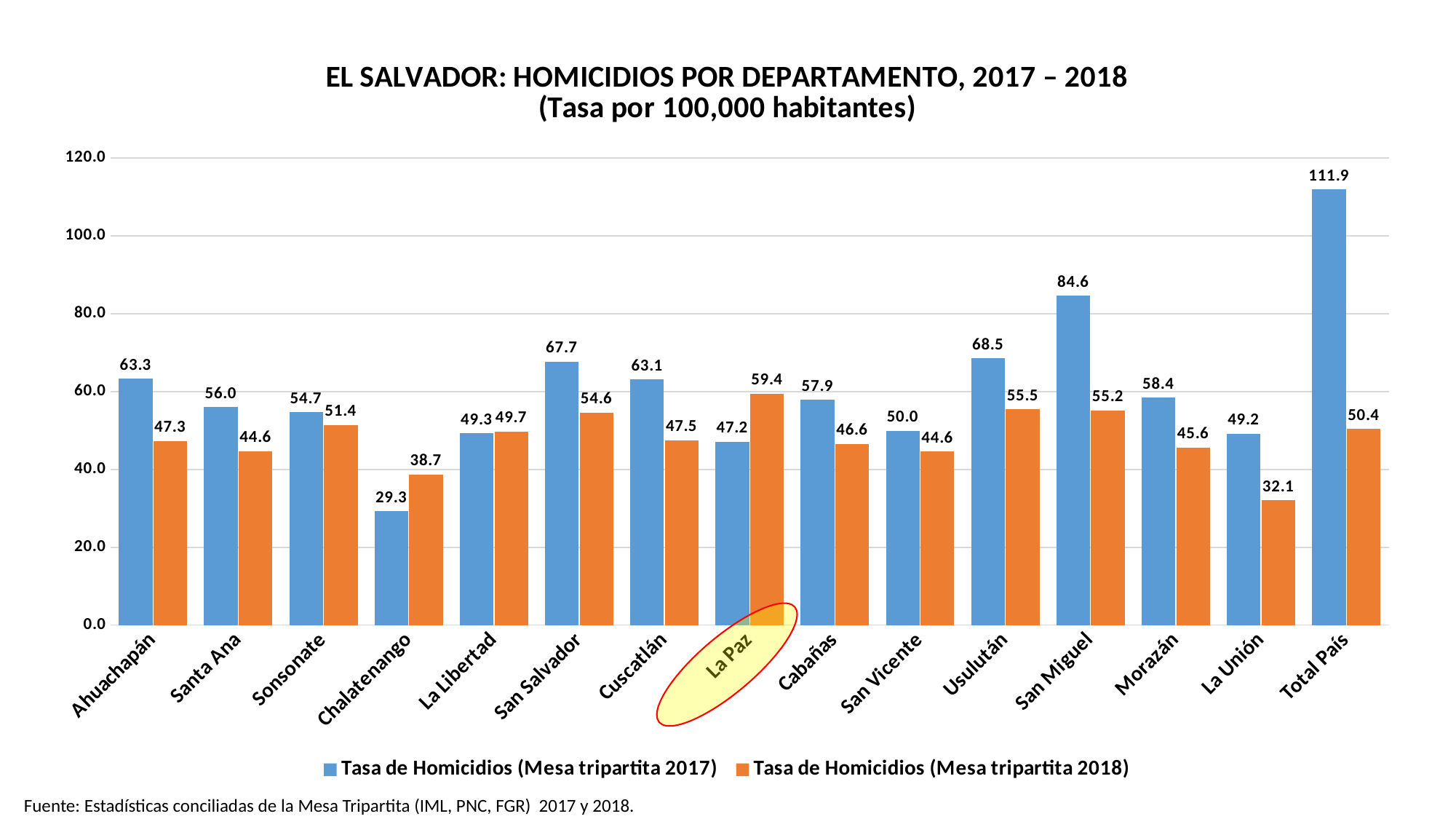
What is the 2018 homicide rate for Total País? 50.4 What is the 2018 homicide rate (Mesa tripartita 2018) for La Paz? 59.4 What is the 2017 homicide rate (Mesa tripartita 2017) for San Miguel? 84.6 Which category has the lowest 2017 homicide rate? Chalatenango What kind of chart is shown on the slide? Bar chart Which is larger for La Paz: the 2017 rate or the 2018 rate? The 2018 rate Which department (excluding Total País) has the highest 2017 homicide rate? San Miguel How many categories are shown on the x axis? 15 What is the difference between the 2017 and 2018 homicide rates for Total País? 61.5 Which category on the x axis is highlighted with a red-outlined yellow oval? La Paz How many series does the legend list? 2 Which category has the lowest 2018 homicide rate? La Unión